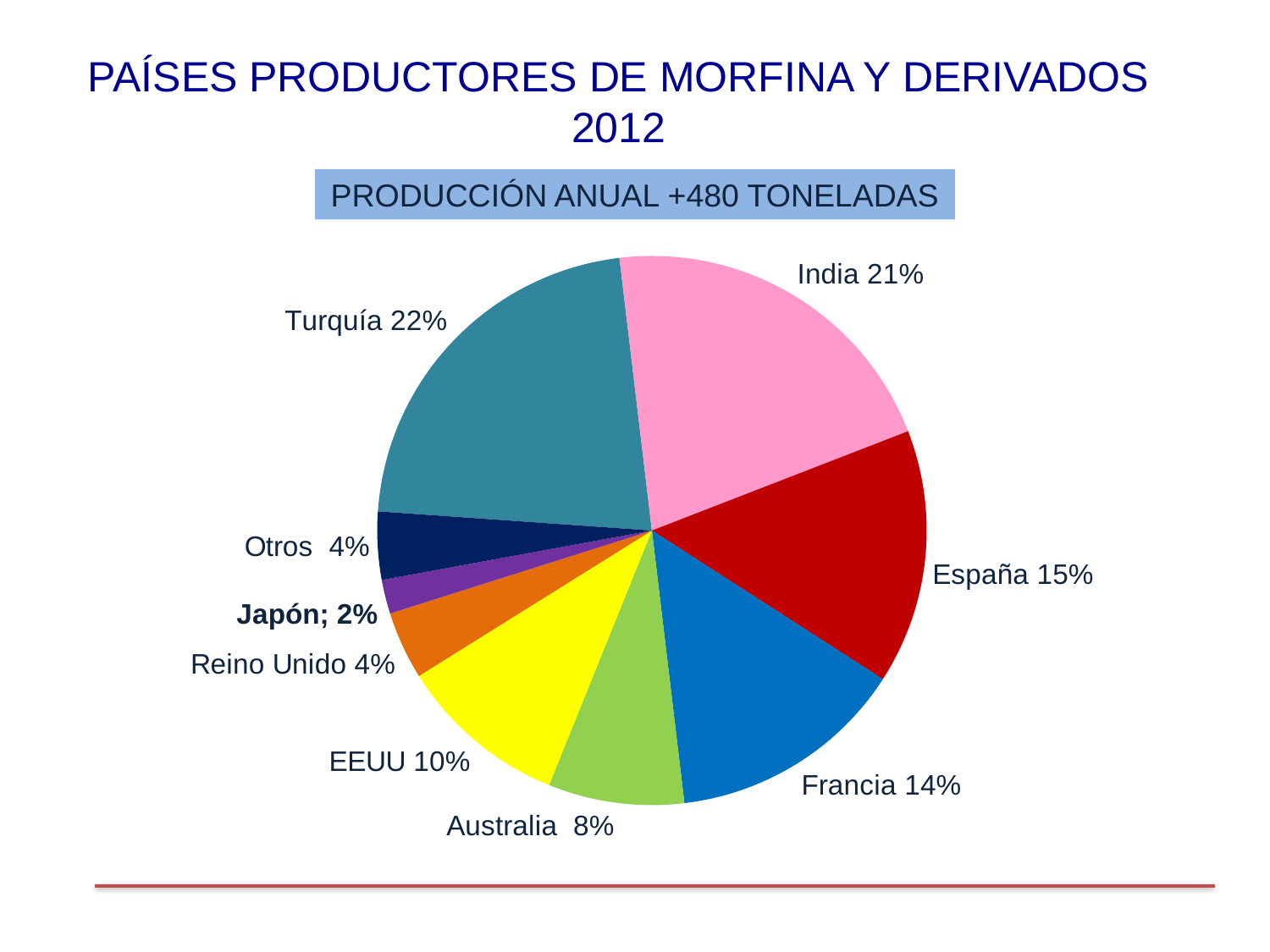
What is the value shown for Japón? 2% What kind of chart is shown on the slide? Pie chart What is the value shown for India? 21% What is the value for Francia? 14% What share does EEUU have? 10% Which category has the smallest slice of the pie? Japón What is the difference between the shares of India and Australia? 13% What share of the pie does Turquía hold? 22% How many slices does the pie chart have? 9 What percentage is shown for España? 15% Which category has the largest slice of the pie? Turquía Which is larger, the share for España or the share for EEUU? España